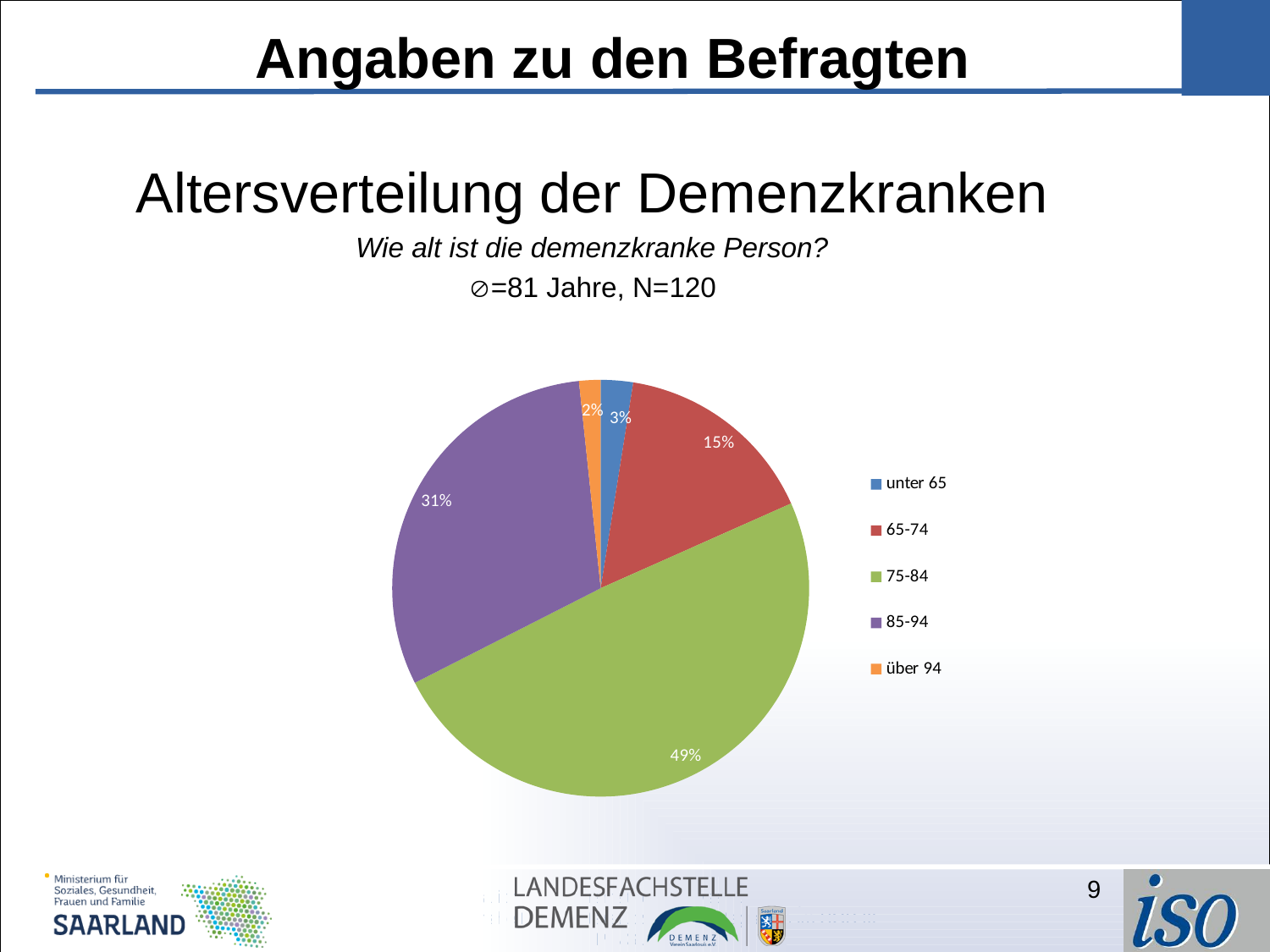
Which age group has the smallest share of the pie? über 94 Which age group has the largest share of the pie? 75-84 What is the value shown for the 'unter 65' age group? 3% What share of the pie does the 85-94 age group have? 31% What is the value shown for the 'über 94' age group? 2% What is the difference in percentage points between the 75-84 and 85-94 age groups? 18 What is the value shown for the 65-74 age group? 15% How many age groups does the legend list? 5 Which is larger, the share for 65-74 or the share for 85-94? 85-94 What share of the pie does the 75-84 age group have? 49% What kind of chart is shown on the slide? pie chart What colour is the slice for the 75-84 age group? green